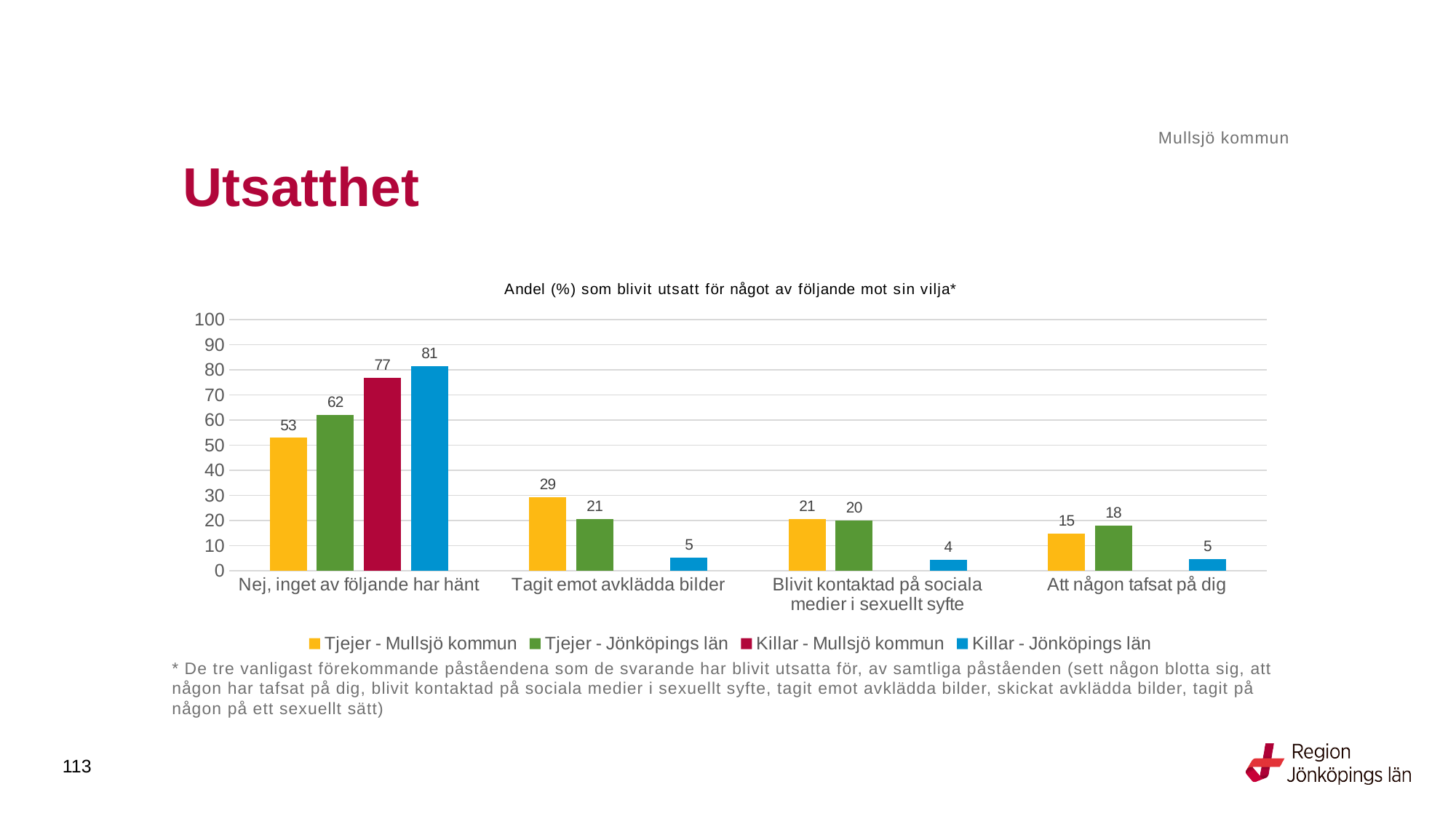
What is the title of the chart? Andel (%) som blivit utsatt för något av följande mot sin vilja* What is the value for Killar - Mullsjö kommun in the category 'Nej, inget av följande har hänt'? 77 What is the value for Killar - Jönköpings län in the category 'Tagit emot avklädda bilder'? 5 How many series does the legend list? 4 What is the value for Tjejer - Jönköpings län in the category 'Att någon tafsat på dig'? 18 How many categories are shown on the x axis? 4 What is the difference between Tjejer - Mullsjö kommun and Tjejer - Jönköpings län in the category 'Tagit emot avklädda bilder'? 8 Which is larger in the category 'Att någon tafsat på dig': Tjejer - Mullsjö kommun or Tjejer - Jönköpings län? Tjejer - Jönköpings län Which series has the highest value in the category 'Nej, inget av följande har hänt'? Killar - Jönköpings län Which category has the lowest value for Killar - Jönköpings län? Blivit kontaktad på sociala medier i sexuellt syfte What kind of chart is shown on the slide? Bar chart What is the value for Tjejer - Mullsjö kommun in the category 'Nej, inget av följande har hänt'? 53